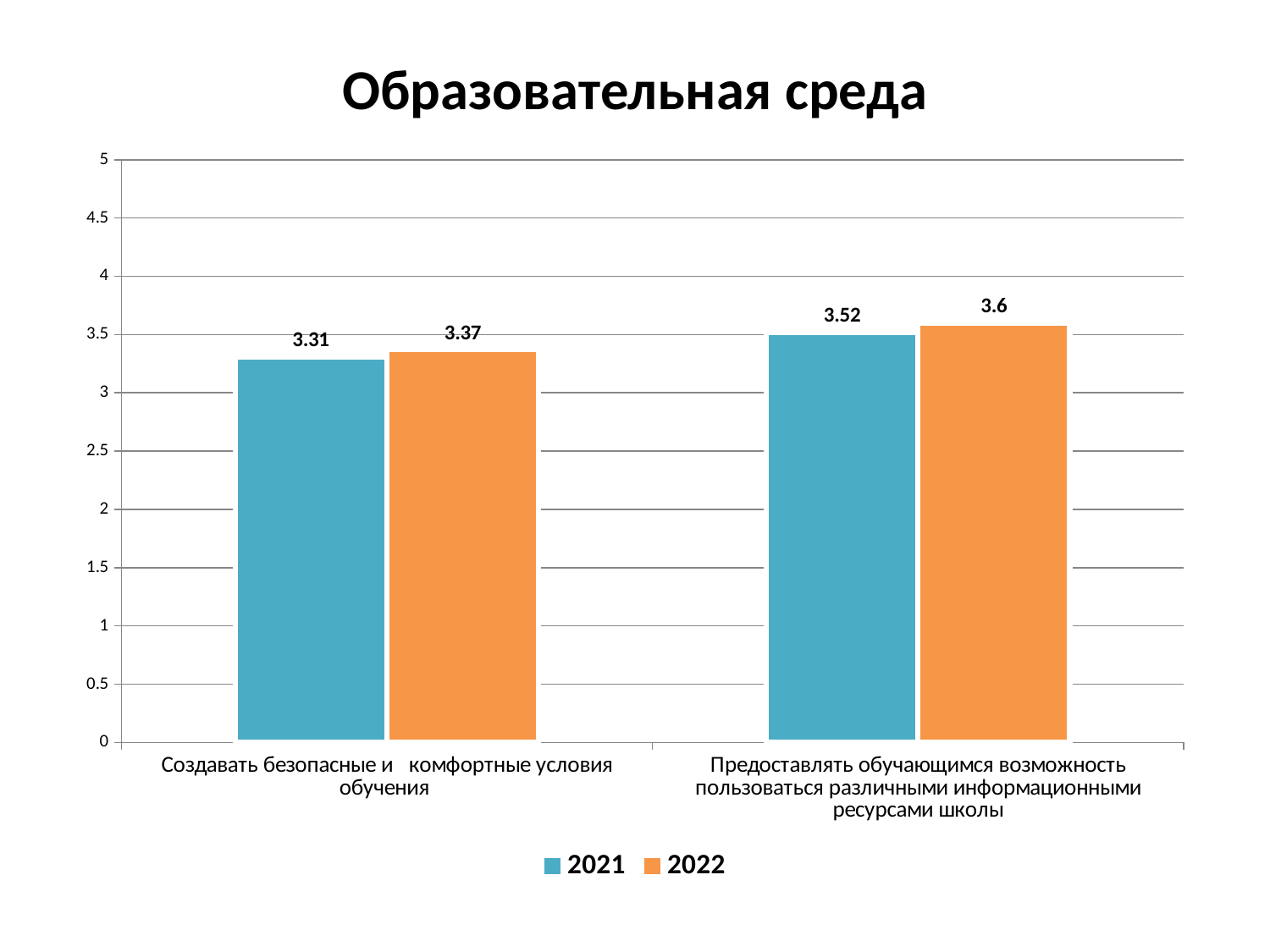
What is the 2022 value for "Предоставлять обучающимся возможность пользоваться различными информационными ресурсами школы"? 3.6 How many categories are shown on the x axis? 2 Is the 2021 value for "Предоставлять обучающимся возможность пользоваться различными информационными ресурсами школы" greater or less than 4? less Which category has the lowest 2021 value? Создавать безопасные и комфортные условия обучения What is the 2021 value for "Предоставлять обучающимся возможность пользоваться различными информационными ресурсами школы"? 3.52 Which category has the highest 2022 value? Предоставлять обучающимся возможность пользоваться различными информационными ресурсами школы How many series does the legend list? 2 What kind of chart is shown on the slide? bar chart What is the 2022 value for "Создавать безопасные и комфортные условия обучения"? 3.37 What is the 2021 value for "Создавать безопасные и комфортные условия обучения"? 3.31 What is the difference between the 2021 values of the two categories? 0.21 What is the difference between the 2022 and 2021 values for "Создавать безопасные и комфортные условия обучения"? 0.06